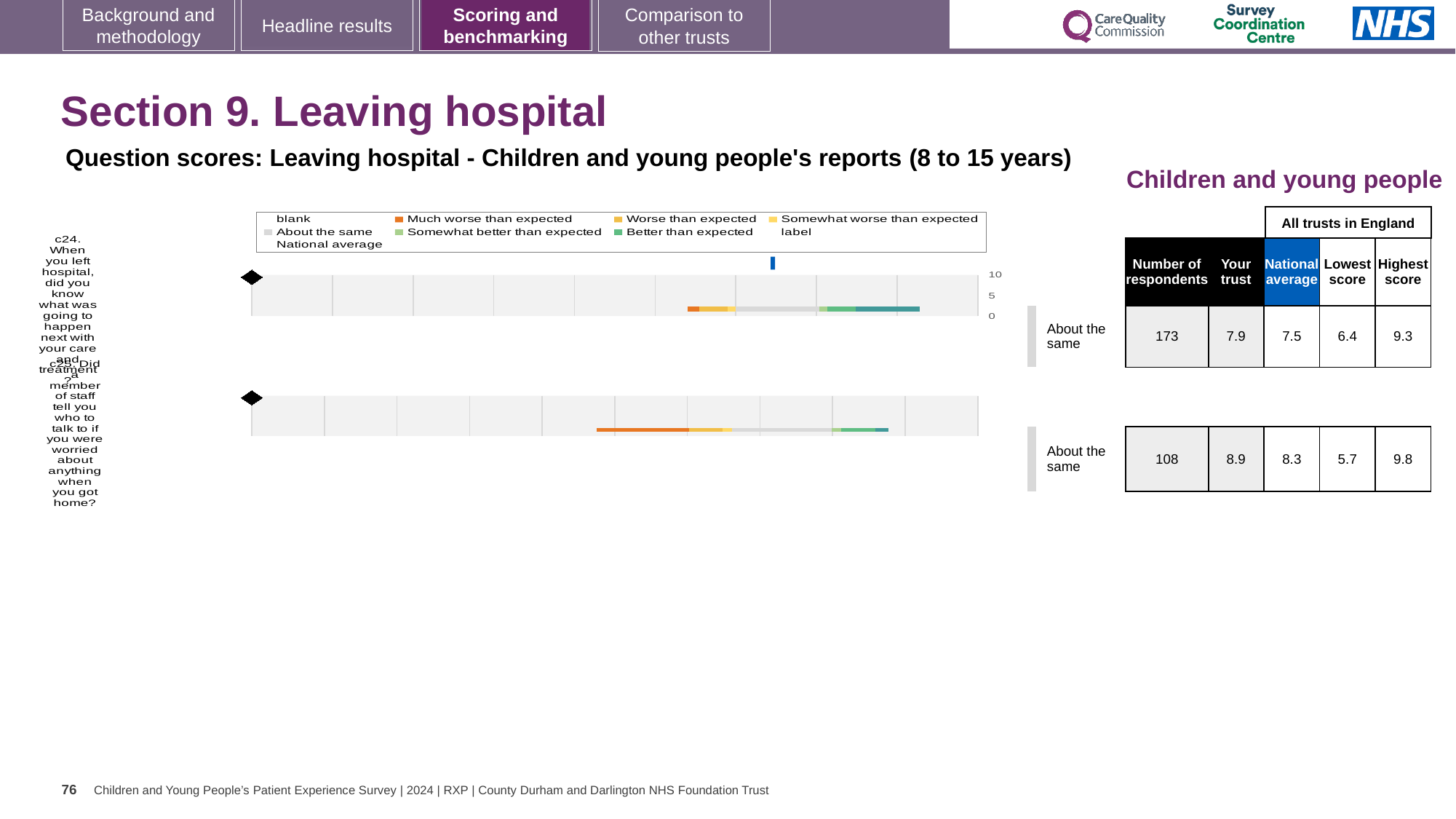
Which question has the lowest 'Lowest score' across all trusts in England? c25 What is the national average score for question c25 (Did a member of staff tell you who to talk to if you were worried about anything when you got home?)? 8.3 How many questions (categories) are plotted in the chart? 2 Which question has the higher 'Your trust' score, c24 or c25? c25 What is the 'Your trust' score for question c24 (When you left hospital, did you know what was going to happen next with your care and treatment?)? 7.9 What is the highest score across all trusts in England for question c25? 9.8 How many respondents answered question c24? 173 What is the difference between the highest and lowest scores across all trusts in England for question c24? 2.9 What kind of chart is shown on the slide? Bar chart What is the lowest score across all trusts in England for question c24? 6.4 What benchmark category is shown for both questions c24 and c25? About the same What is the difference between the 'Your trust' score and the national average for question c25? 0.6